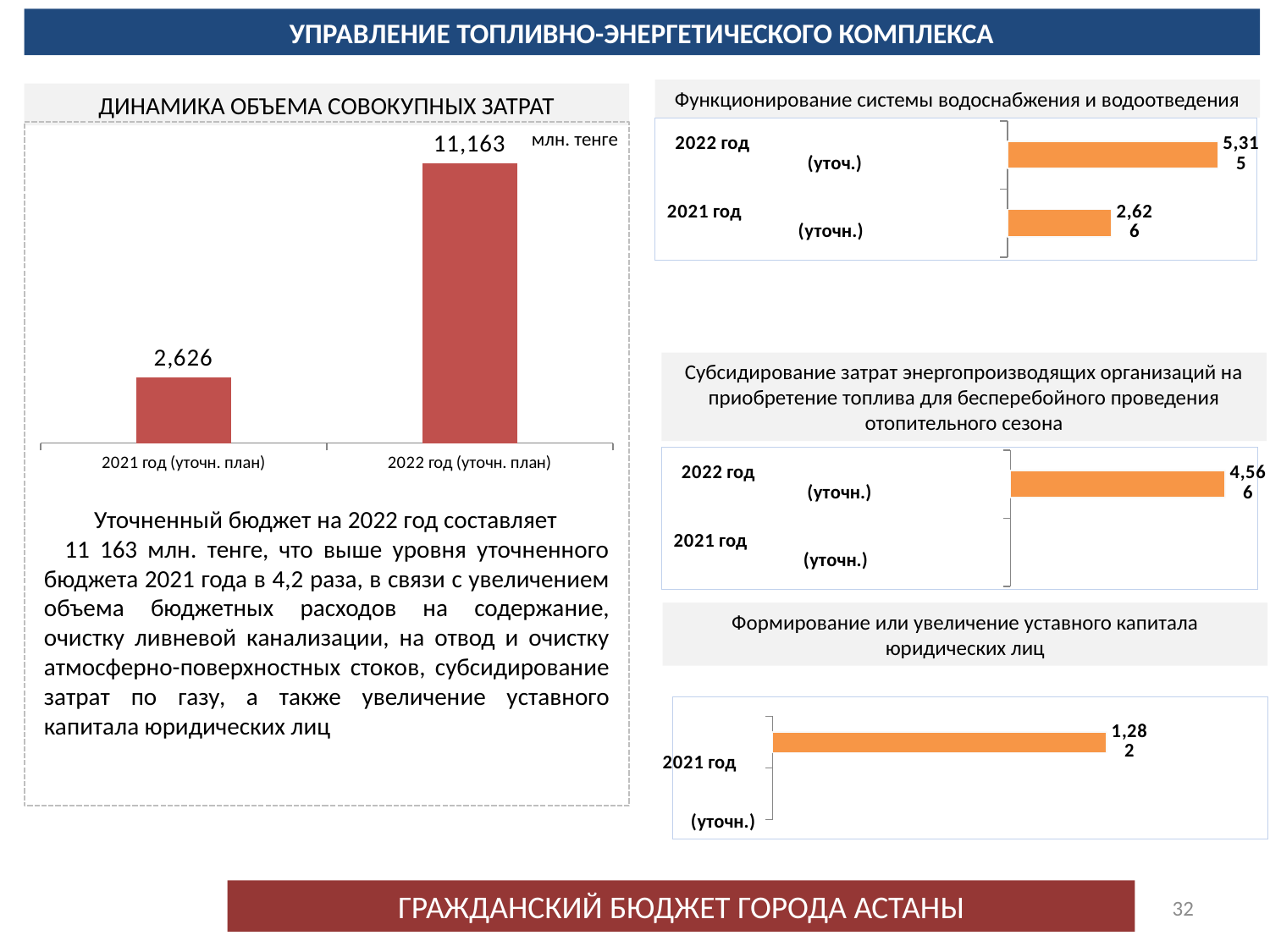
In the chart titled 'ДИНАМИКА ОБЪЕМА СОВОКУПНЫХ ЗАТРАТ', what is the difference between the 2022 and 2021 values? 8,537 In the chart titled 'Функционирование системы водоснабжения и водоотведения', what is the value for 2022 год (уточ.)? 5,315 In the chart titled 'ДИНАМИКА ОБЪЕМА СОВОКУПНЫХ ЗАТРАТ', what unit is shown for the values? млн. тенге How many bars are plotted in the chart titled 'Формирование или увеличение уставного капитала юридических лиц'? 1 In the chart titled 'ДИНАМИКА ОБЪЕМА СОВОКУПНЫХ ЗАТРАТ', which category has the highest value? 2022 год (уточн. план) In the chart titled 'Субсидирование затрат энергопроизводящих организаций на приобретение топлива для бесперебойного проведения отопительного сезона', what is the value for 2022 год (уточн.)? 4,566 What type of chart is 'ДИНАМИКА ОБЪЕМА СОВОКУПНЫХ ЗАТРАТ'? bar chart In the chart titled 'ДИНАМИКА ОБЪЕМА СОВОКУПНЫХ ЗАТРАТ', what is the value for 2021 год (уточн. план)? 2,626 In the chart titled 'ДИНАМИКА ОБЪЕМА СОВОКУПНЫХ ЗАТРАТ', what is the value for 2022 год (уточн. план)? 11,163 In the chart titled 'Функционирование системы водоснабжения и водоотведения', which year has the larger value, 2022 or 2021? 2022 год In the chart titled 'Функционирование системы водоснабжения и водоотведения', what is the value for 2021 год (уточн.)? 2,626